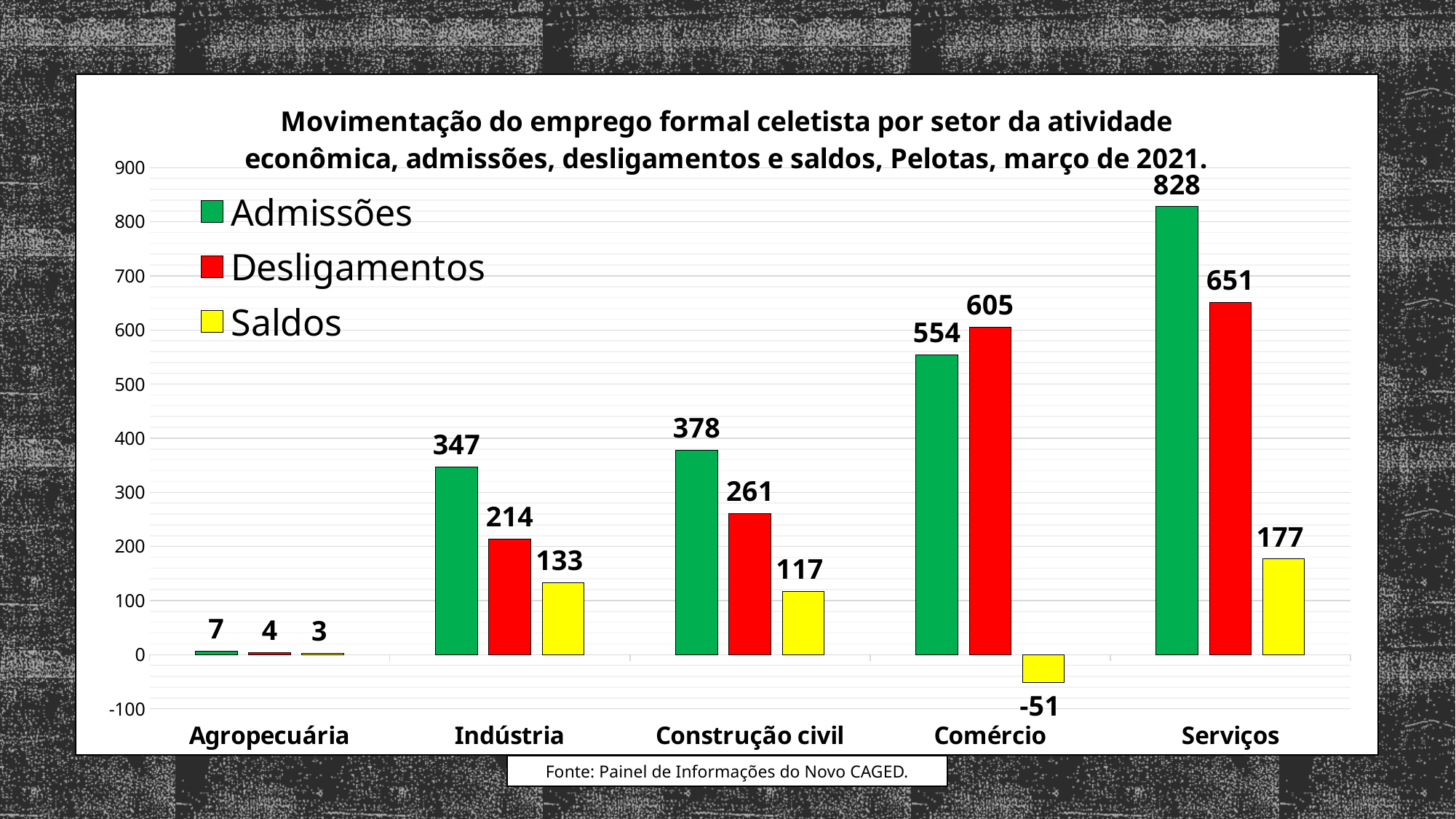
How many sectors are shown on the x axis? 5 What is the difference between Admissões and Desligamentos for Indústria? 133 What is the Saldos value for Construção civil? 117 What is the Desligamentos value for Comércio? 605 What is the source cited below the chart? Painel de Informações do Novo CAGED Which is larger for Comércio, Admissões or Desligamentos? Desligamentos What kind of chart is shown on the slide? Bar chart What is the Admissões value for Serviços? 828 What colour represents the Saldos series? Yellow Which sector has the highest Admissões value? Serviços Which sector has the lowest Saldos value? Comércio How many series does the legend list? 3